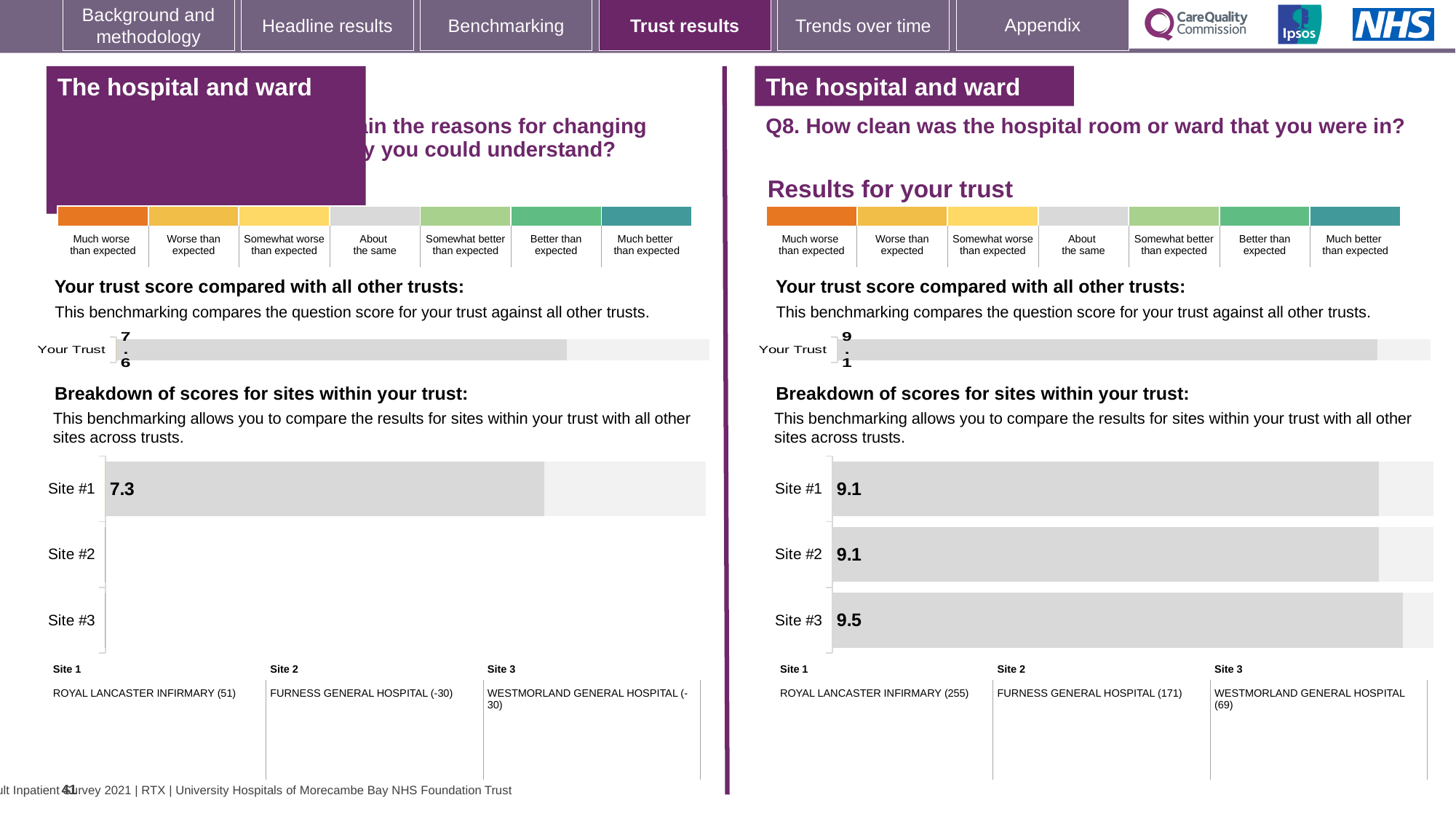
On the left-hand site breakdown chart, which hospital is Site 1? ROYAL LANCASTER INFIRMARY (51) On the right-hand chart for Q8, is the score for Site #3 larger than the score for Site #1? Yes, Site #3 On the left-hand site breakdown chart, what is the score for Site #1? 7.3 On the right-hand 'Your trust score compared with all other trusts' chart for Q8, what is the score for Your Trust? 9.1 How many sites are listed on the right-hand site breakdown chart for Q8? 3 On the right-hand chart for Q8, what is the difference between the scores for Site #3 and Site #2? 0.4 What kind of chart is the right-hand site breakdown chart for Q8? Bar chart On the right-hand site breakdown chart for Q8, which hospital is Site 3? WESTMORLAND GENERAL HOSPITAL (69) On the right-hand chart for Q8, what is the score for Site #1? 9.1 On the right-hand chart for Q8, which site has the highest score? Site #3 On the left-hand 'Your trust score compared with all other trusts' chart, what is the score for Your Trust? 7.6 On the right-hand chart for Q8 (how clean was the hospital room or ward), what is the score for Site #3? 9.5